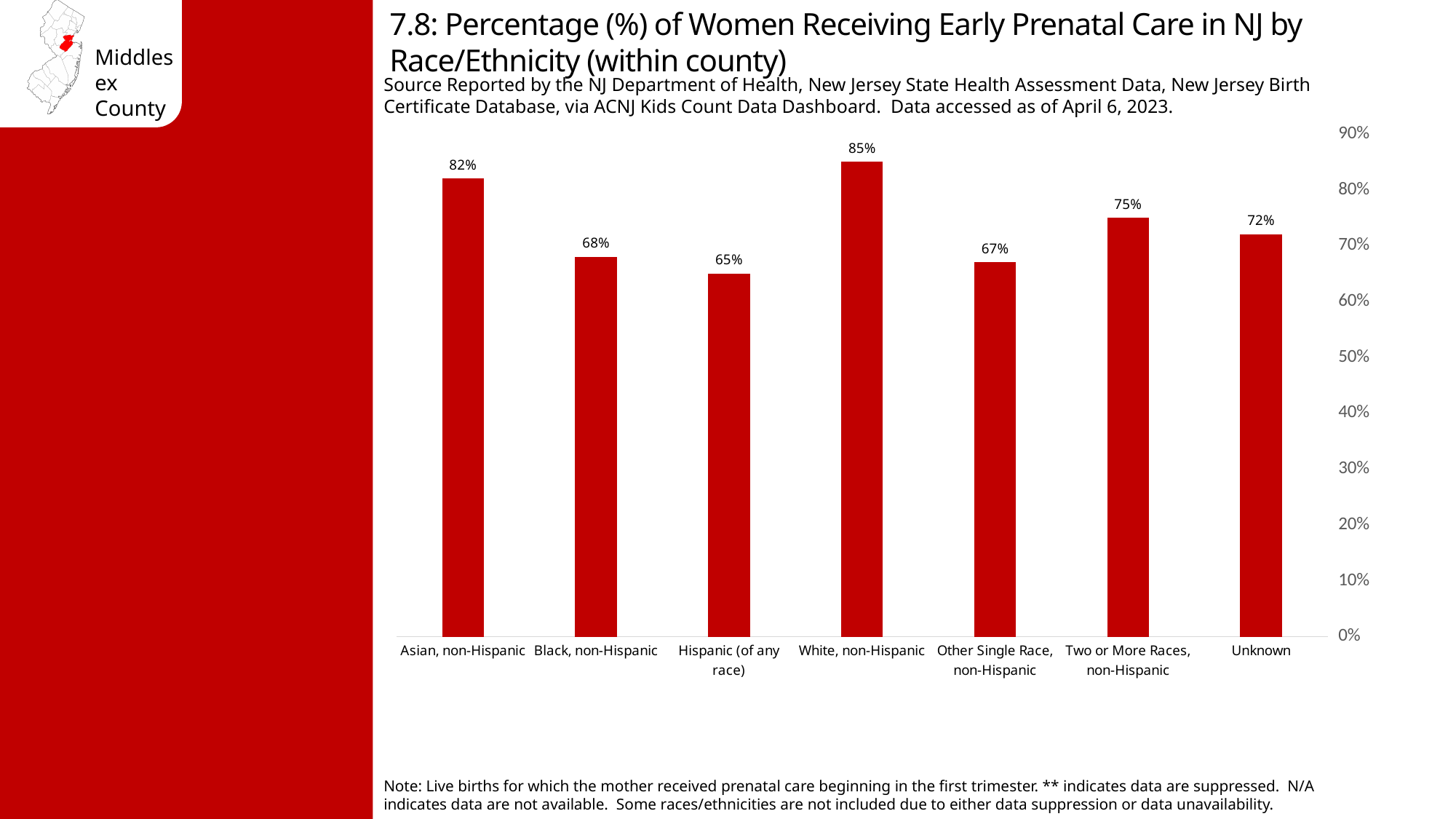
Which race/ethnicity category has the lowest percentage? Hispanic (of any race) What type of chart is used on this slide? Bar chart What percentage is shown for the Unknown category? 72% What is the difference between the White, non-Hispanic value and the Black, non-Hispanic value? 17% What is the difference between the Two or More Races, non-Hispanic value and the Other Single Race, non-Hispanic value? 8% What is the maximum value shown on the vertical axis? 90% How many race/ethnicity categories are shown on the chart? 7 What is the value shown for Hispanic (of any race)? 65% Which race/ethnicity category has the highest percentage of women receiving early prenatal care? White, non-Hispanic What percentage of Asian, non-Hispanic women received early prenatal care? 82% Is the value for Black, non-Hispanic greater or less than 70%? less Which is larger: the value for Asian, non-Hispanic or the value for Two or More Races, non-Hispanic? Asian, non-Hispanic